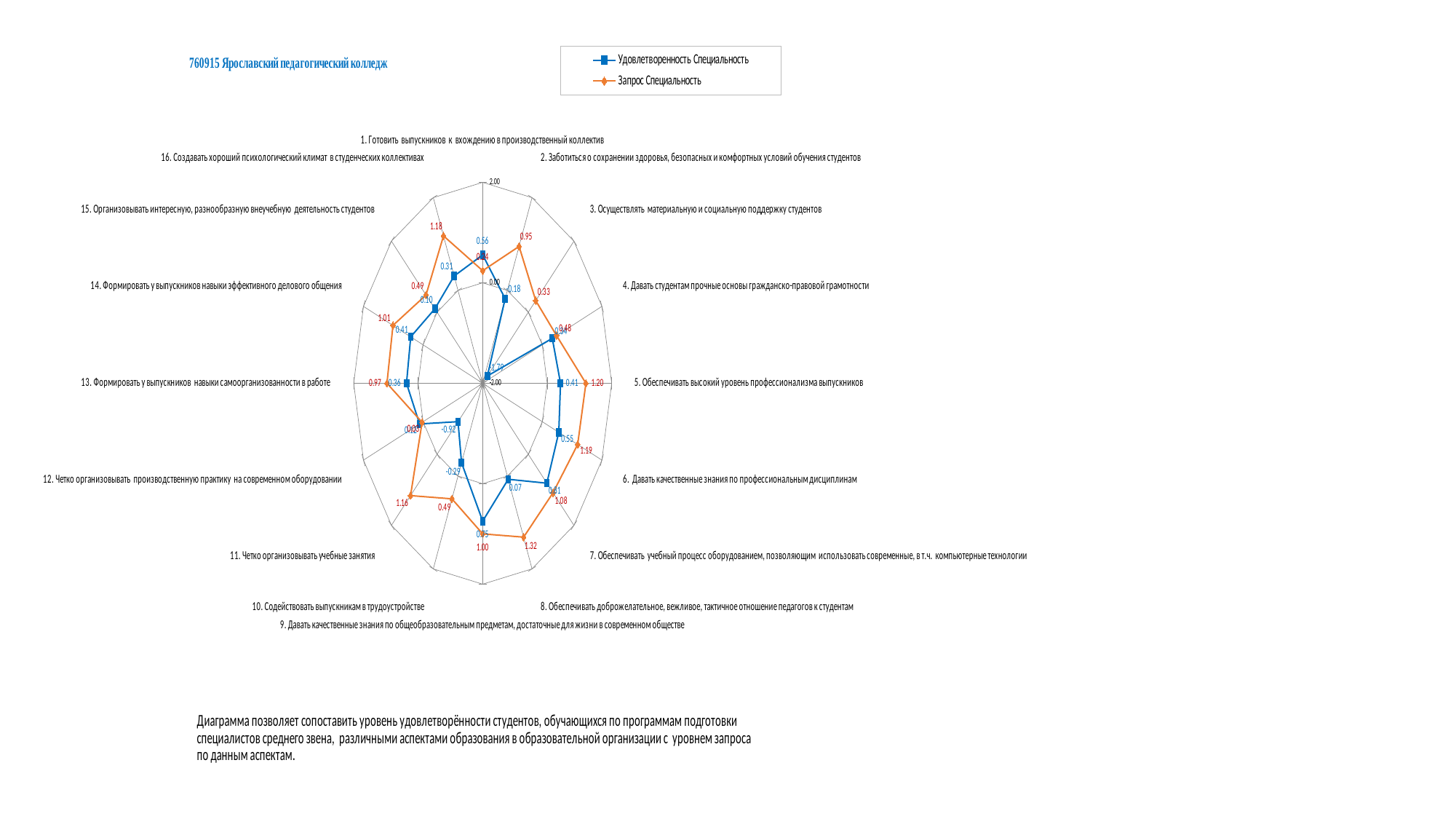
For category 13 'Формировать у выпускников навыки самоорганизованности в работе', which series has the larger value: 'Запрос Специальность' or 'Удовлетворенность Специальность'? Запрос Специальность What is the value of 'Удовлетворенность Специальность' for category 9 'Давать качественные знания по общеобразовательным предметам, достаточные для жизни в современном обществе'? 0.75 How many categories (axes) does the radar chart have? 16 What kind of chart is shown on the slide? Radar chart For category 5 'Обеспечивать высокий уровень профессионализма выпускников', what is the difference between 'Запрос Специальность' and 'Удовлетворенность Специальность'? 0.79 How many series does the legend list? 2 What is the value of 'Запрос Специальность' for category 8 'Обеспечивать доброжелательное, вежливое, тактичное отношение педагогов к студентам'? 1.32 For category 9 'Давать качественные знания по общеобразовательным предметам, достаточные для жизни в современном обществе', what is the difference between 'Запрос Специальность' and 'Удовлетворенность Специальность'? 0.25 What is the value of 'Удовлетворенность Специальность' for category 11 'Четко организовывать учебные занятия'? -0.92 What is the value of 'Запрос Специальность' for category 5 'Обеспечивать высокий уровень профессионализма выпускников'? 1.20 What are the two series names listed in the legend? Удовлетворенность Специальность; Запрос Специальность For which category does 'Запрос Специальность' reach its highest value? 8. Обеспечивать доброжелательное, вежливое, тактичное отношение педагогов к студентам